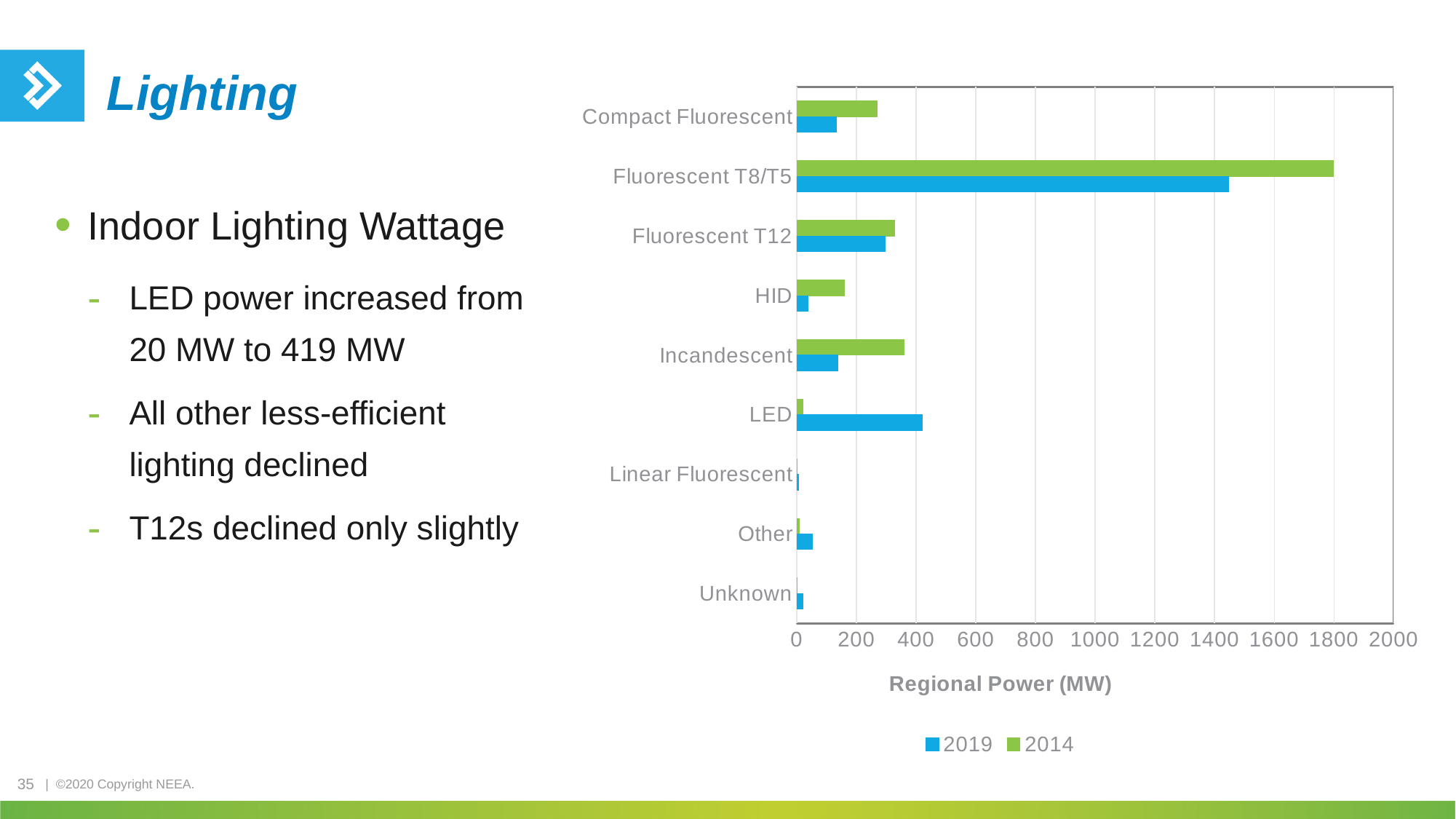
For Incandescent, which series is larger, 2019 or 2014? 2014 Is the 2014 value for Incandescent greater or less than 400? less Is the 2014 value for HID greater or less than 200? less What kind of chart is shown on the slide? bar chart Is the 2019 value for Fluorescent T8/T5 greater or less than 1400? greater How many lighting categories are plotted on the chart? 9 For LED, which series is larger, 2019 or 2014? 2019 What is the title of the chart's horizontal axis? Regional Power (MW) Which category has the highest 2019 value? Fluorescent T8/T5 Which category has the highest 2014 value? Fluorescent T8/T5 How many series does the chart legend list? 2